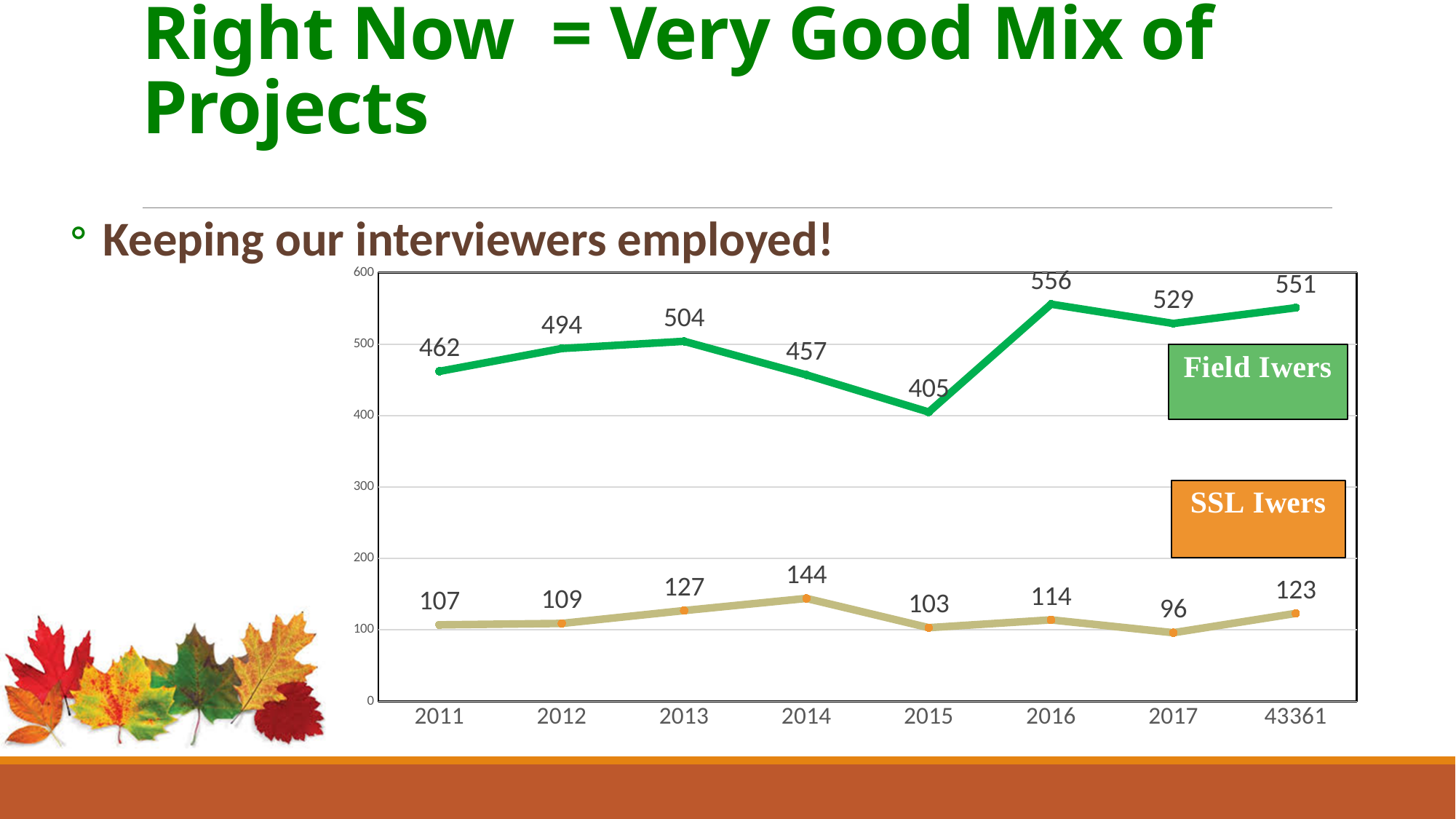
In which year is the Field Iwers value lowest? 2015 How many years are shown on the x axis? 8 In which year is the SSL Iwers value lowest? 2017 Which is larger, the Field Iwers value for 2013 or for 2014? 2013 What is the Field Iwers value for 2011? 462 What is the Field Iwers value for 2016? 556 What is the difference between the SSL Iwers values for 2014 and 2017? 48 What is the SSL Iwers value for 2014? 144 What colour is the Field Iwers line? green What kind of chart is shown on the slide? line chart What is the difference between the Field Iwers values for 2016 and 2015? 151 In which year is the SSL Iwers value highest? 2014